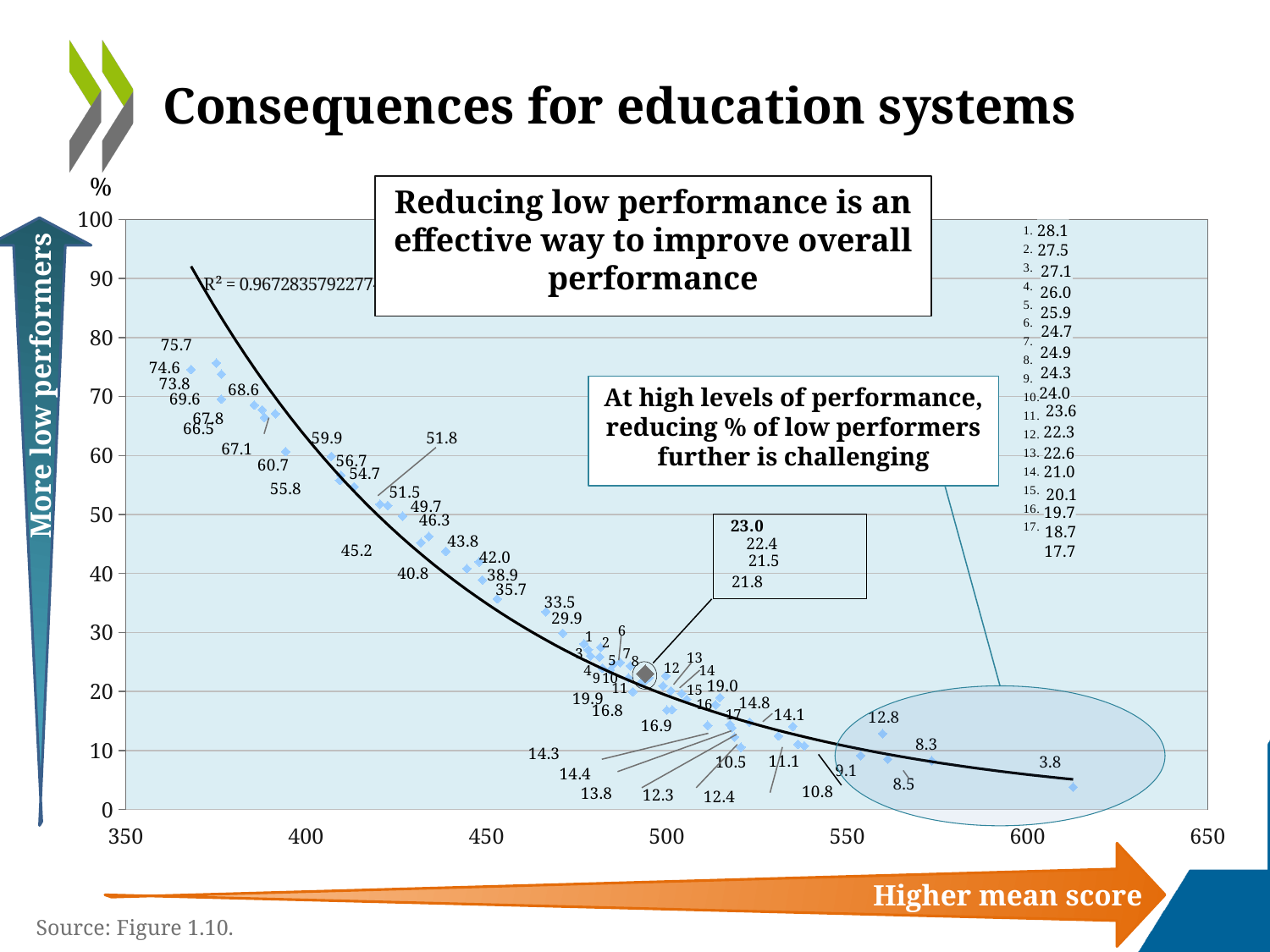
What is the bold value shown in the callout box pointing to the highlighted diamond marker? 23.0 How many numbered entries are in the list on the right side of the chart? 17 In the numbered list on the right of the chart, what value is listed for point 17? 18.7 What kind of chart is shown on the slide? scatter chart In the numbered list on the right of the chart, what value is listed for point 1? 28.1 What is the lowest data label value shown on the chart? 3.8 What is the difference between the highest data label (75.7) and the lowest data label (3.8) on the chart? 71.9 Which is larger, the point labelled 12.8 or the point labelled 8.3? 12.8 As the mean score increases along the x axis, do the percentages of low performers rise or fall? fall What is the title of the slide containing the chart? Consequences for education systems What is the maximum value shown on the x axis of the chart? 650 What is the highest data label value shown on the chart? 75.7